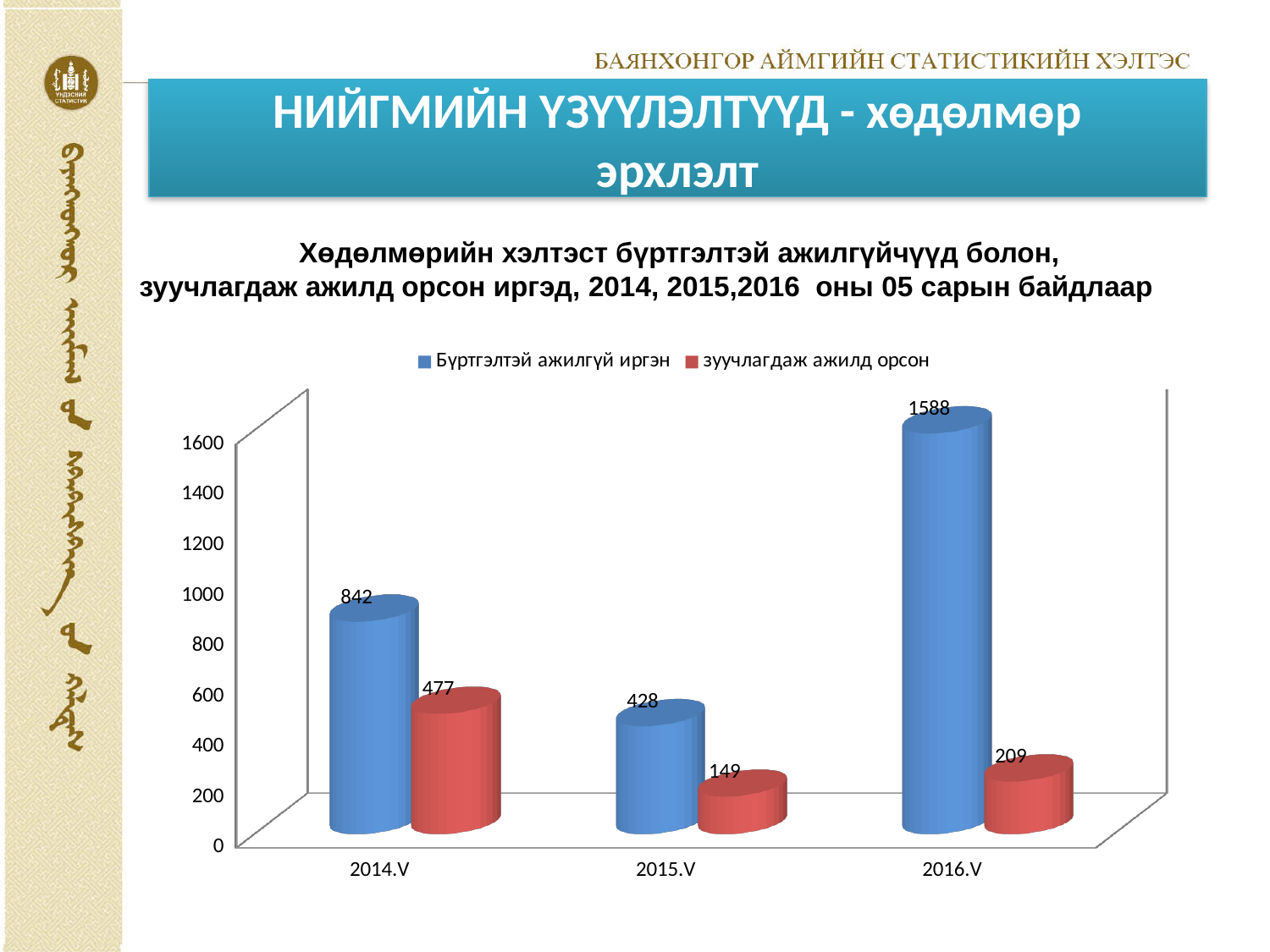
What is the difference between Бүртгэлтэй ажилгүй иргэн and зуучлагдаж ажилд орсон in 2016.V? 1379 How many periods are shown on the x axis? 3 What kind of chart is shown on the slide? bar chart Which is larger: зуучлагдаж ажилд орсон in 2014.V or in 2016.V? 2014.V What is the value for Бүртгэлтэй ажилгүй иргэн in 2015.V? 428 Which period has the lowest value for зуучлагдаж ажилд орсон? 2015.V What is the value for Бүртгэлтэй ажилгүй иргэн in 2016.V? 1588 What is the value for зуучлагдаж ажилд орсон in 2014.V? 477 What is the value for зуучлагдаж ажилд орсон in 2015.V? 149 How many series does the legend list? 2 Which period has the highest value for Бүртгэлтэй ажилгүй иргэн? 2016.V What is the difference between the Бүртгэлтэй ажилгүй иргэн values for 2014.V and 2015.V? 414